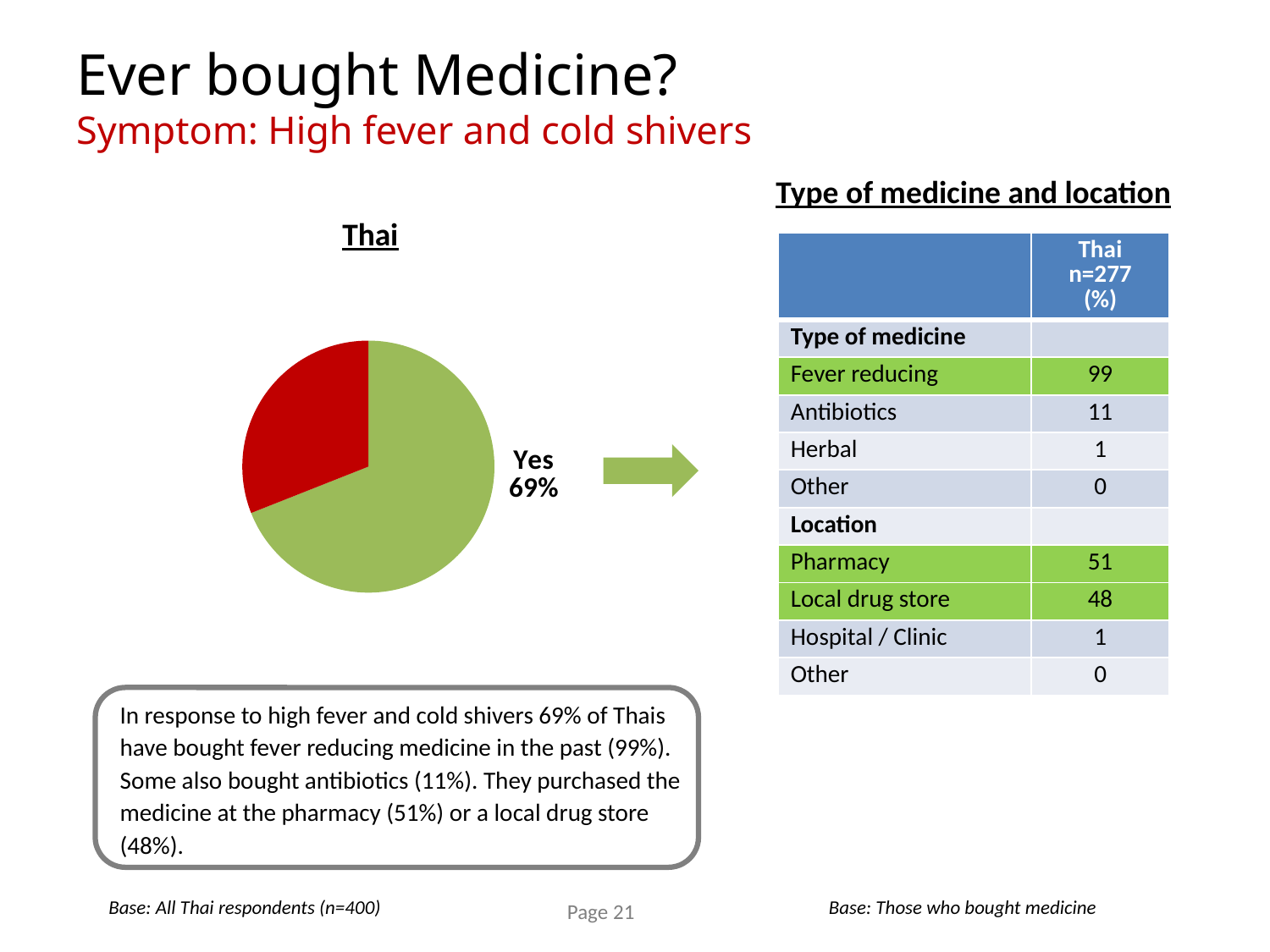
Is the red slice of the pie chart greater or less than 50% of the pie? less What share of the pie does the "Yes" slice represent? 69% Is the share of the "Yes" slice greater or less than 50%? greater How many slices does the pie chart have? 2 What is the title of the pie chart? Thai Which slice of the pie chart is the largest? Yes What kind of chart is shown on the slide? pie chart What colour is the "Yes" slice in the pie chart? green Which slice is larger in the pie chart, the green slice or the red slice? the green slice What value is printed for the "Yes" slice of the pie chart? 69%